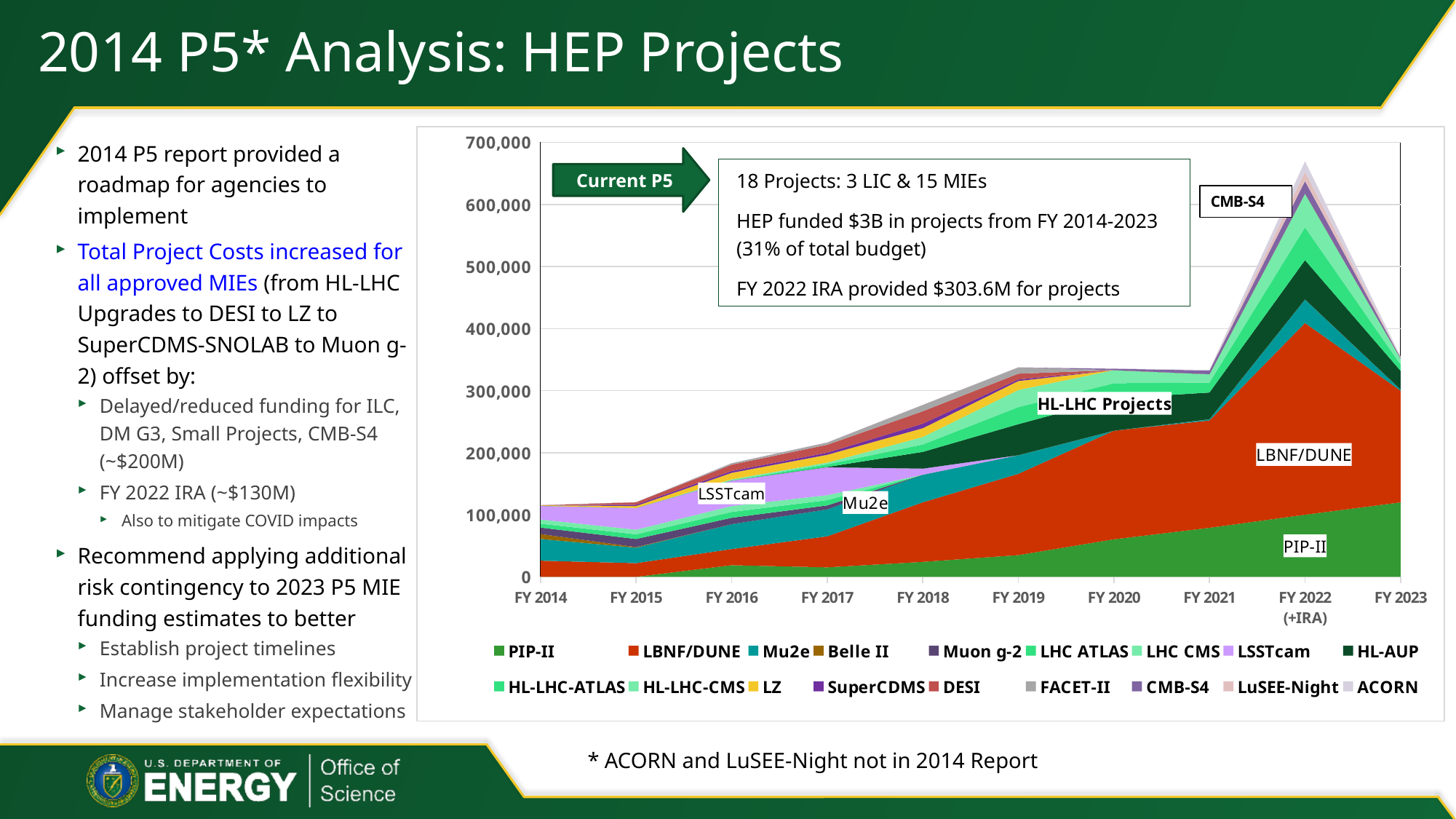
Is the total stacked value for FY 2022 (+IRA) greater or less than 600,000? greater Which series is plotted at the bottom of the stack in the chart? PIP-II In which fiscal year is the total stacked value highest? FY 2022 (+IRA) How many fiscal years are shown along the x axis of the chart? 10 How many series does the chart's legend list? 18 Which has the larger total stacked value, FY 2022 (+IRA) or FY 2023? FY 2022 (+IRA) Does the total stacked value rise or fall from FY 2014 to FY 2019? Rise Is the total stacked value for FY 2021 greater or less than 400,000? less Is the value for PIP-II in FY 2023 greater or less than 100,000? greater What kind of chart is shown on the slide? Stacked area chart